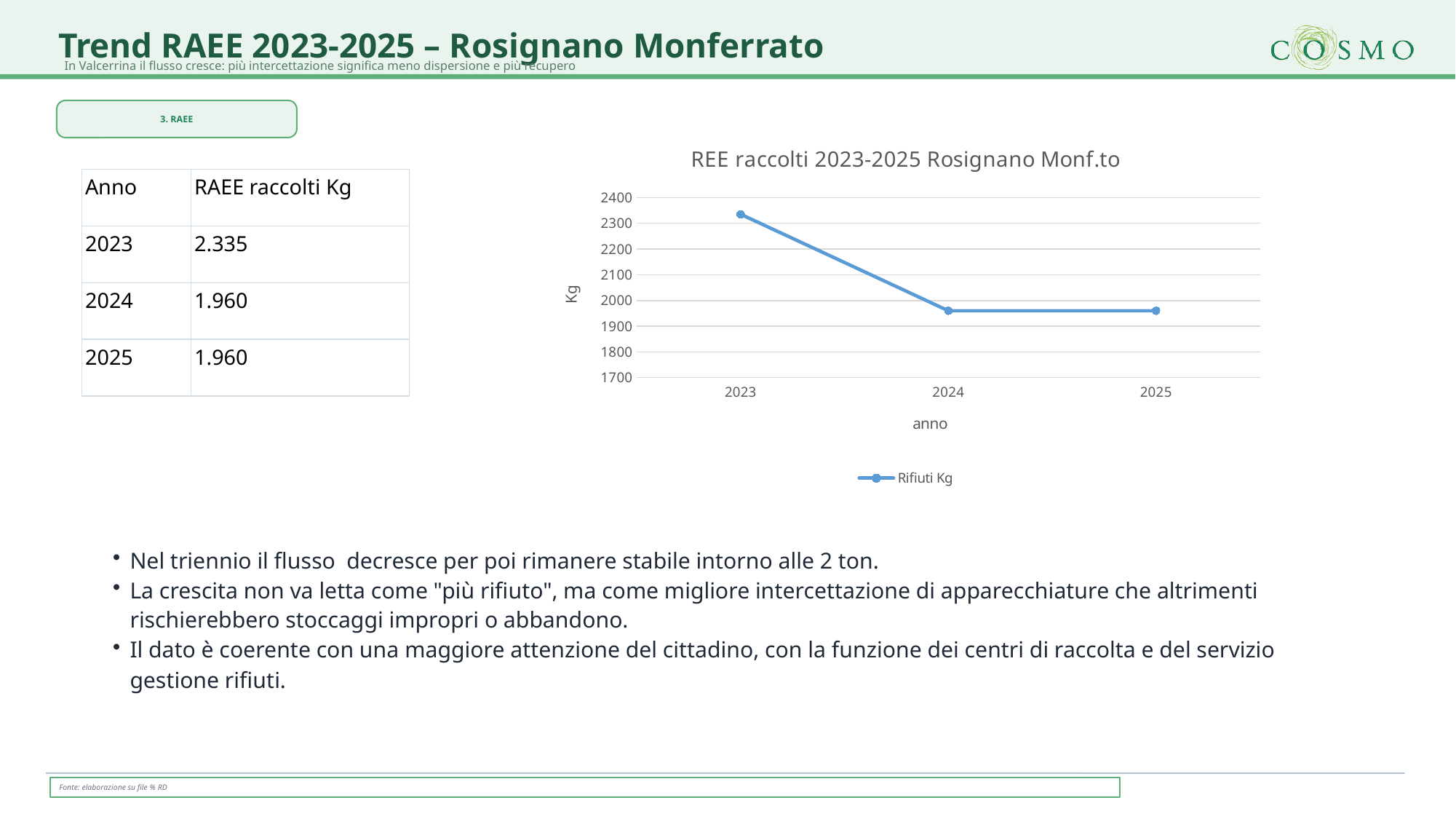
Is the value for 2023 greater or less than 2300? greater Is the value for 2024 greater or less than 2000? less How many series does the legend list? 1 Do the values rise or fall from 2023 to 2024? fall Which is larger, the value for 2023 or the value for 2024? 2023 According to the table, how many Kg of RAEE were collected in 2023? 2.335 How many years are plotted on the x axis of the chart? 3 Is the value for 2025 greater or less than 1900? greater What series name does the chart legend show? Rifiuti Kg Which year has the highest value in the chart? 2023 What is the title of the chart? REE raccolti 2023-2025 Rosignano Monf.to What kind of chart is shown on the slide? line chart